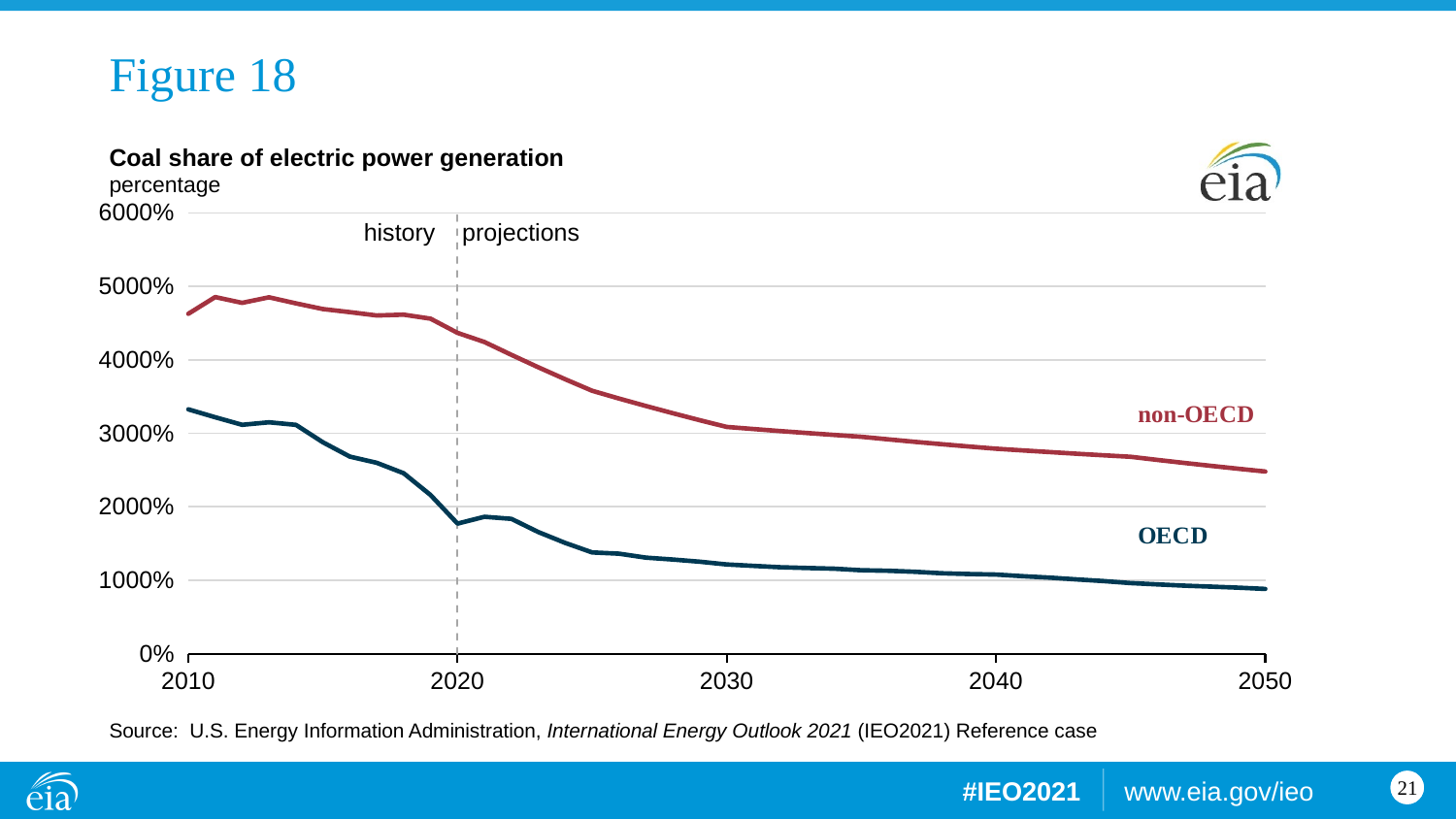
Is the value for OECD in 2030 greater or less than 1000%? greater Is the value for OECD in 2050 greater or less than 1000%? less Is the value for non-OECD in 2010 greater or less than 4000%? greater Does the non-OECD line rise or fall from 2020 to 2050? fall What year does the dashed vertical line separating history from projections fall on? 2020 Does the OECD line rise or fall from 2010 to 2050? fall What is the title of the chart? Coal share of electric power generation What kind of chart is shown on the slide? line chart Which series has the higher value in 2050, non-OECD or OECD? non-OECD How many series are plotted on the chart? 2